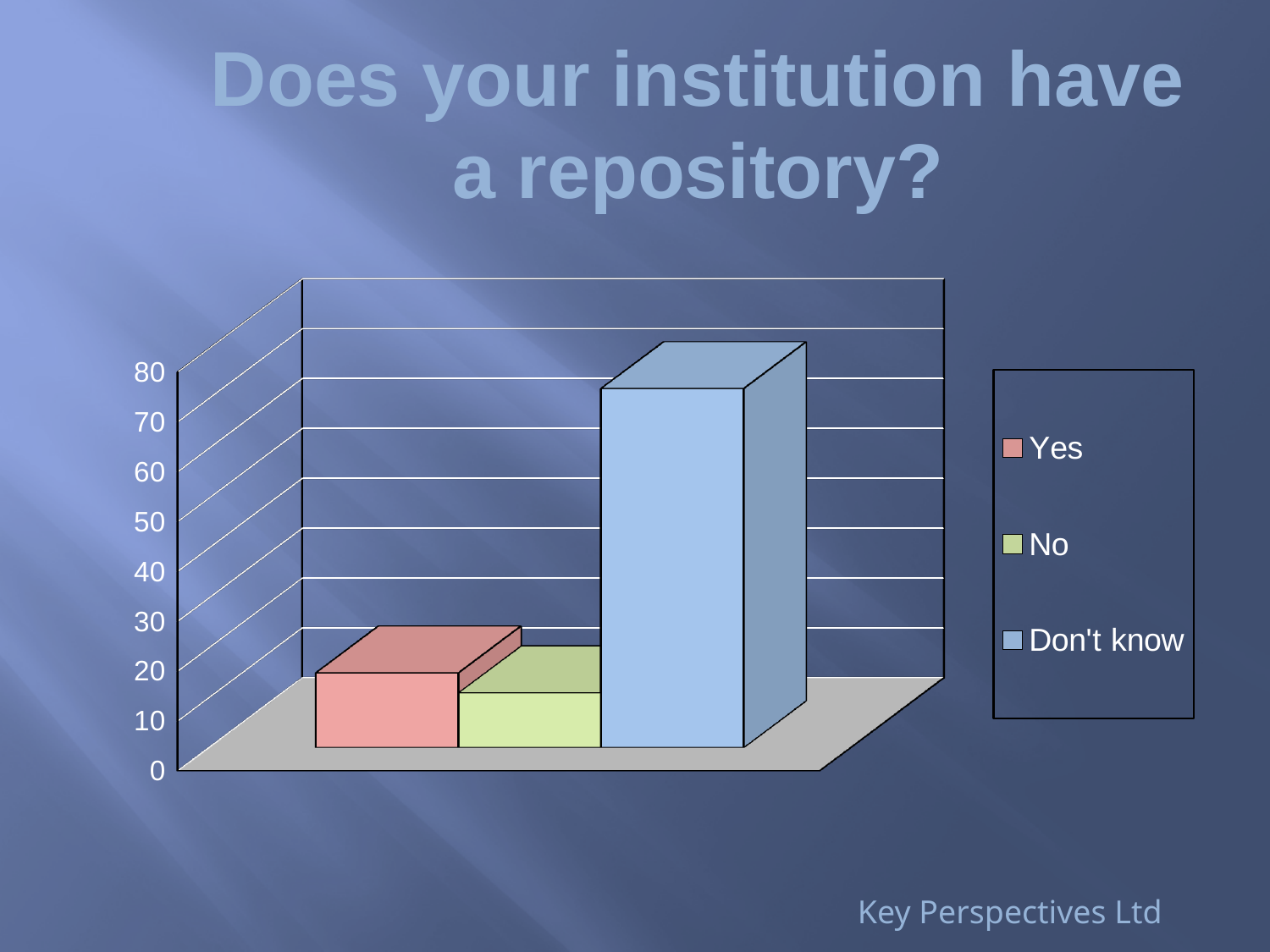
What colour is the bar for Don't know in the chart? blue Is the value for No greater or less than 30? less How many bars are plotted in the chart? 3 Which is larger, the value for Don't know or the value for Yes? Don't know Which response has the highest bar in the chart? Don't know What kind of chart is shown on the slide? bar chart Is the value for Don't know greater or less than 60? greater Is the value for Yes greater or less than 30? less Which response has the lowest bar in the chart? No How many entries does the chart's legend list? 3 Which is larger, the value for Yes or the value for No? Yes What is the title of the chart on the slide? Does your institution have a repository?